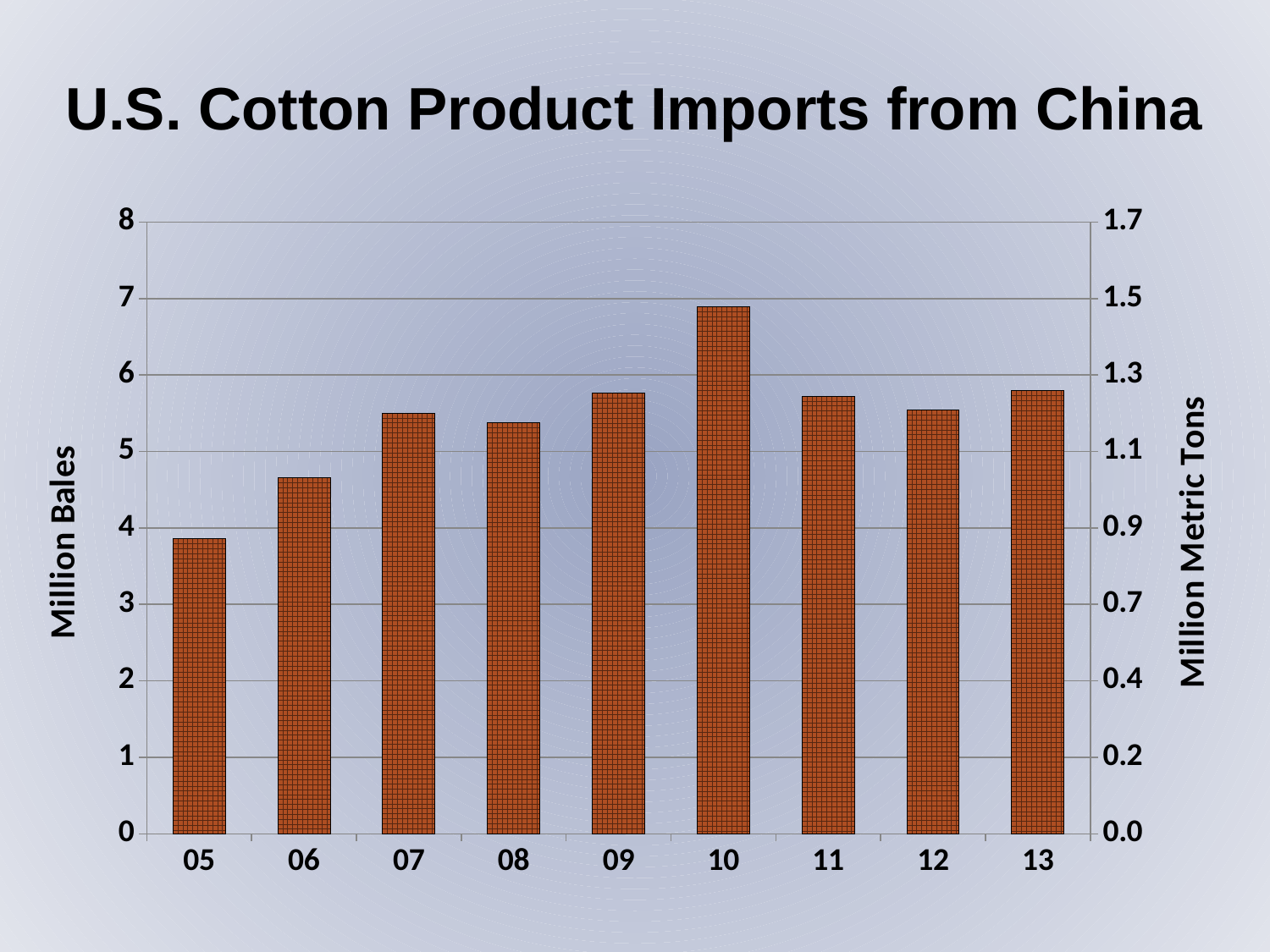
Is the value for 10 greater or less than 6 million bales? greater Which year has the lowest U.S. cotton product imports from China? 05 Do the values rise or fall from 05 to 07? rise What is the label of the left vertical axis? Million Bales Which year has the larger value, 10 or 13? 10 Is the value for 05 greater or less than 4 million bales? less Which year has the highest U.S. cotton product imports from China? 10 Which year has the larger value, 06 or 07? 07 How many years (bars) are plotted on the chart? 9 Is the value for 06 greater or less than 5 million bales? less What kind of chart is shown on the slide? bar chart